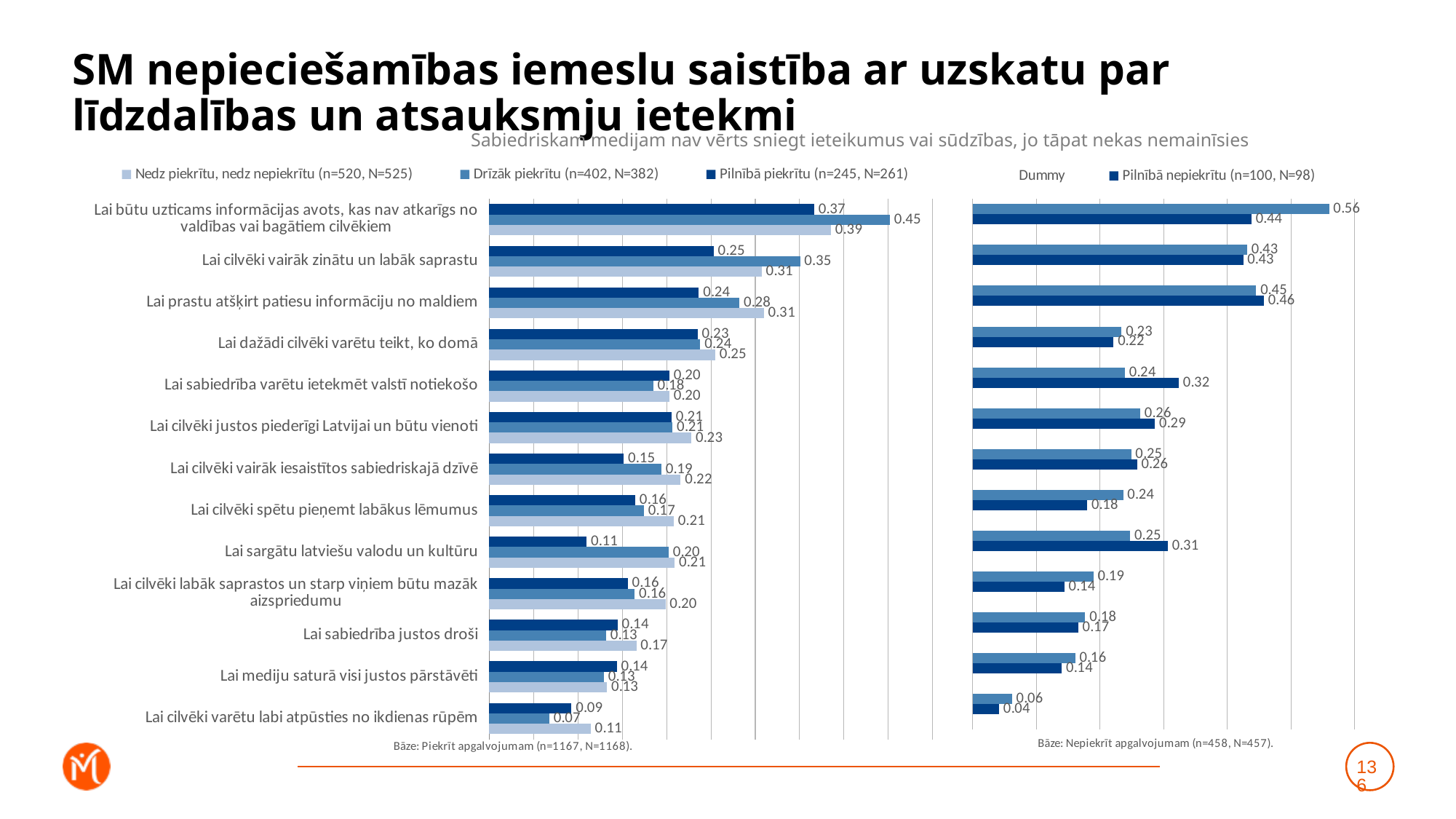
In the left chart, for 'Lai cilvēki vairāk iesaistītos sabiedriskajā dzīvē', which series has the larger value: 'Nedz piekrītu, nedz nepiekrītu' or 'Pilnībā piekrītu'? Nedz piekrītu, nedz nepiekrītu In the left chart, for 'Lai sargātu latviešu valodu un kultūru', what is the difference between the 'Drīzāk piekrītu' value and the 'Pilnībā piekrītu' value? 0.09 In the right chart, what is the highest value shown, and for which category? 0.56, Lai būtu uzticams informācijas avots, kas nav atkarīgs no valdības vai bagātiem cilvēkiem In the left chart, what is the value of the 'Nedz piekrītu, nedz nepiekrītu' series for 'Lai cilvēki varētu labi atpūsties no ikdienas rūpēm'? 0.11 In the left chart, what is the value of the 'Pilnībā piekrītu' series for 'Lai būtu uzticams informācijas avots, kas nav atkarīgs no valdības vai bagātiem cilvēkiem'? 0.37 What is the base note printed under the left chart? Bāze: Piekrīt apgalvojumam (n=1167, N=1168). How many categories (reasons) are listed on the vertical axis of the left chart? 13 In the left chart, which category has the highest value for the 'Drīzāk piekrītu' series? Lai būtu uzticams informācijas avots, kas nav atkarīgs no valdības vai bagātiem cilvēkiem What type of chart is used on this slide? Bar chart In the left chart, what is the value of the 'Drīzāk piekrītu' series for 'Lai cilvēki vairāk zinātu un labāk saprastu'? 0.35 How many series does the legend of the left chart list? 3 In the left chart, which category has the lowest value for the 'Pilnībā piekrītu' series? Lai cilvēki varētu labi atpūsties no ikdienas rūpēm